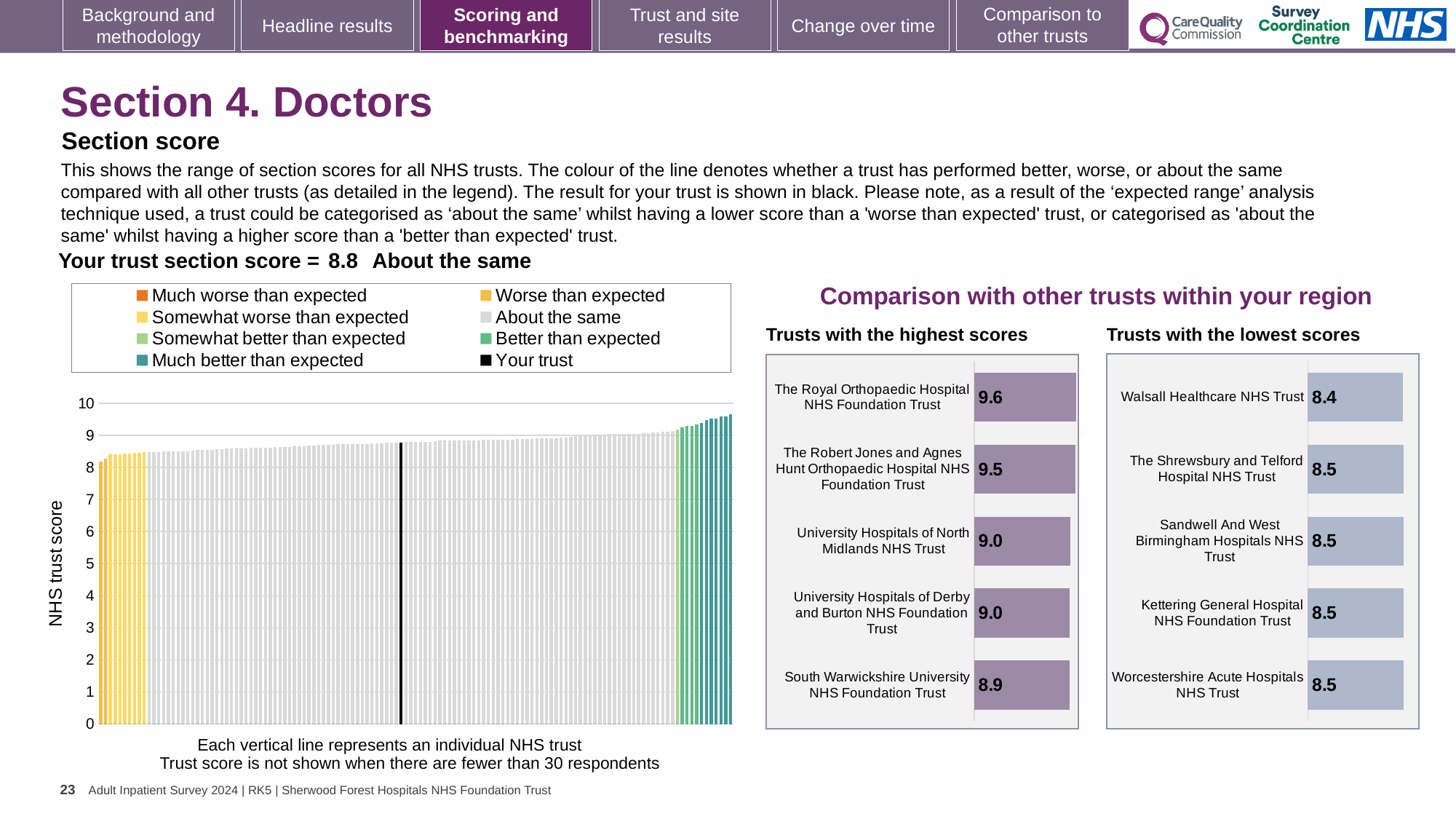
In the 'Trusts with the lowest scores' chart, what is the score for Walsall Healthcare NHS Trust? 8.4 In the 'Trusts with the lowest scores' chart, which trust has the lowest score? Walsall Healthcare NHS Trust In the 'Trusts with the highest scores' chart, which has the larger score: The Robert Jones and Agnes Hunt Orthopaedic Hospital NHS Foundation Trust or University Hospitals of North Midlands NHS Trust? The Robert Jones and Agnes Hunt Orthopaedic Hospital NHS Foundation Trust How many entries does the legend of the 'NHS trust score' chart on the left list? 8 In the 'NHS trust score' chart on the left, what is the section score for your trust (the black bar)? 8.8 How many trusts are listed in the 'Trusts with the highest scores' chart? 5 In the 'Trusts with the highest scores' chart, what is the score for The Royal Orthopaedic Hospital NHS Foundation Trust? 9.6 In the 'Trusts with the highest scores' chart, what is the difference between the scores of The Royal Orthopaedic Hospital NHS Foundation Trust and South Warwickshire University NHS Foundation Trust? 0.7 What kind of chart is the 'NHS trust score' chart on the left of the slide? Bar chart In the 'Trusts with the lowest scores' chart, what is the difference between the scores of The Shrewsbury and Telford Hospital NHS Trust and Walsall Healthcare NHS Trust? 0.1 How many trusts are listed in the 'Trusts with the lowest scores' chart? 5 In the 'Trusts with the highest scores' chart, which trust has the highest score? The Royal Orthopaedic Hospital NHS Foundation Trust